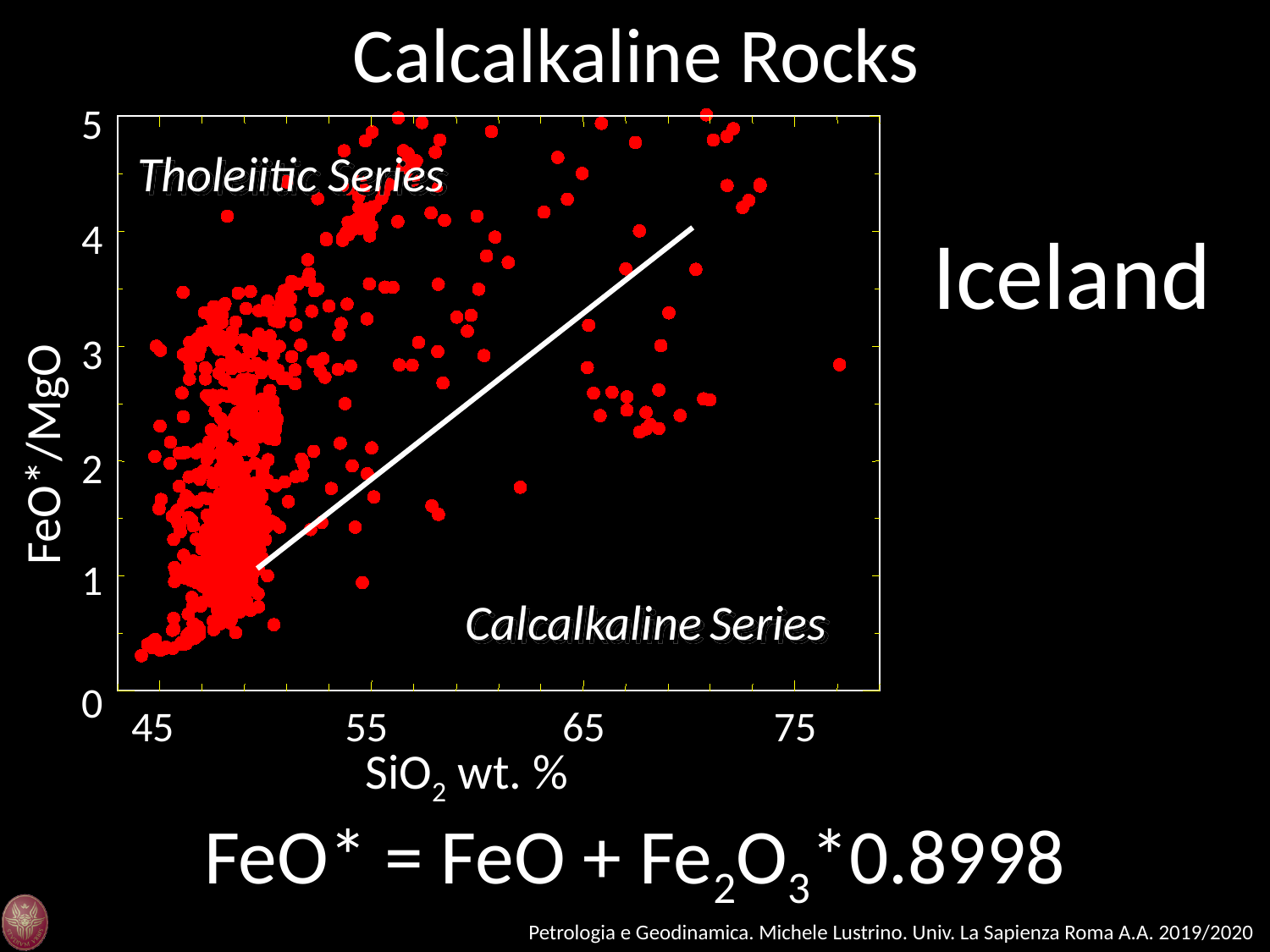
Is the rightmost red point on the chart at FeO*/MgO greater or less than 2? greater Is the densest cluster of red points located at FeO*/MgO greater or less than 4? less Does the white dividing line rise or fall as SiO2 wt. % increases? rise Is the rightmost red point on the chart at SiO2 wt. % greater or less than 75? greater What kind of chart is shown on the slide? scatter chart What label is on the x axis of the chart? SiO2 wt. % What is the title of the chart on the slide? Calcalkaline Rocks